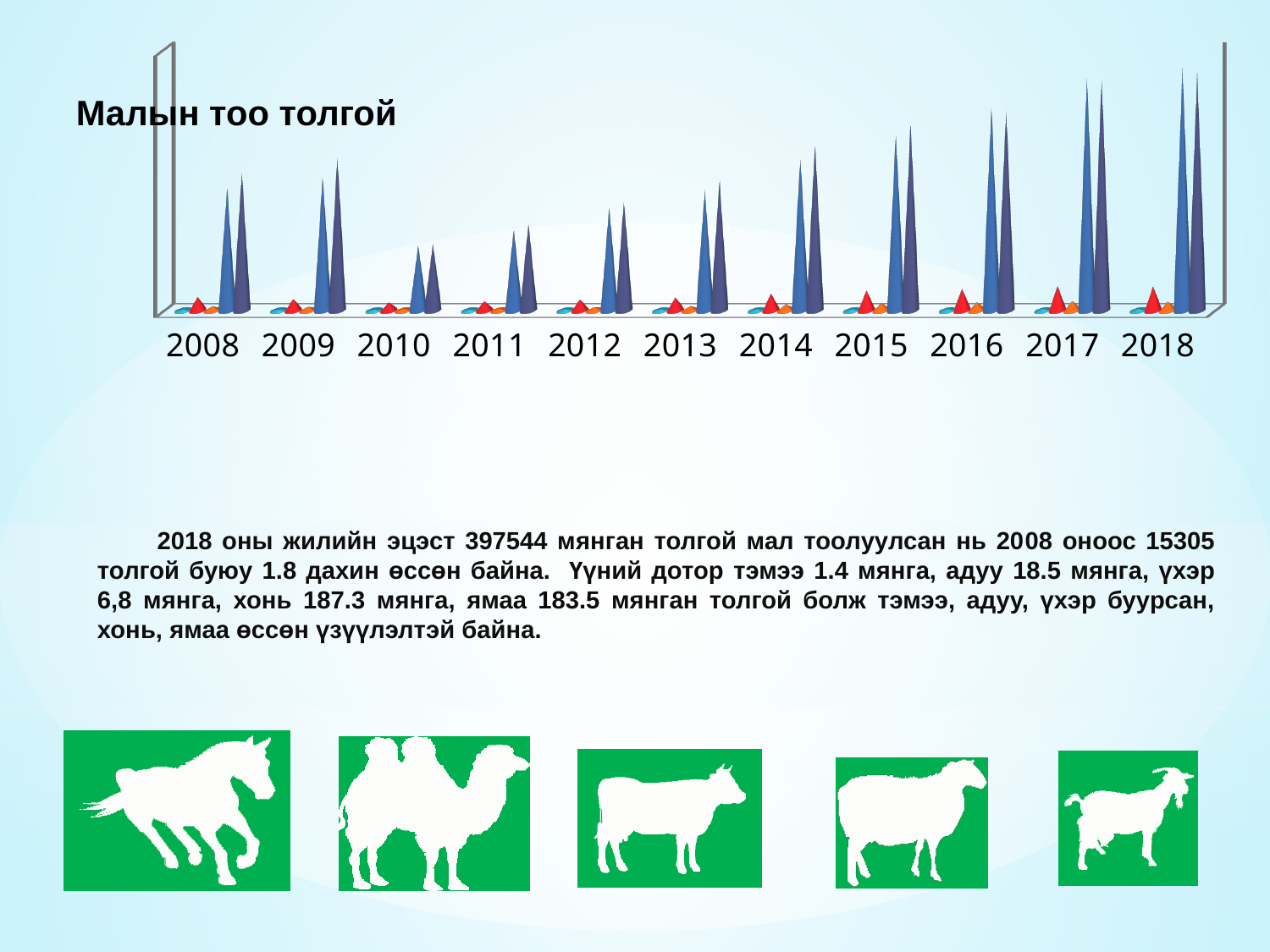
Are the tall blue bars higher in 2009 or in 2010? 2009 In which year do the tallest bars of the chart appear? 2018 How many years are shown on the x axis of the chart? 11 What is the first year shown on the x axis of the chart? 2008 Do the tall blue bars generally rise or fall from 2010 to 2018? rise What is the title of the chart? Малын тоо толгой Are the tall blue bars higher in 2017 or in 2011? 2017 What is the last year shown on the x axis of the chart? 2018 In which year are the tall blue bars of the chart the lowest? 2010 Are the tall blue bars higher in 2018 or in 2008? 2018 What kind of chart is shown on the slide? bar chart